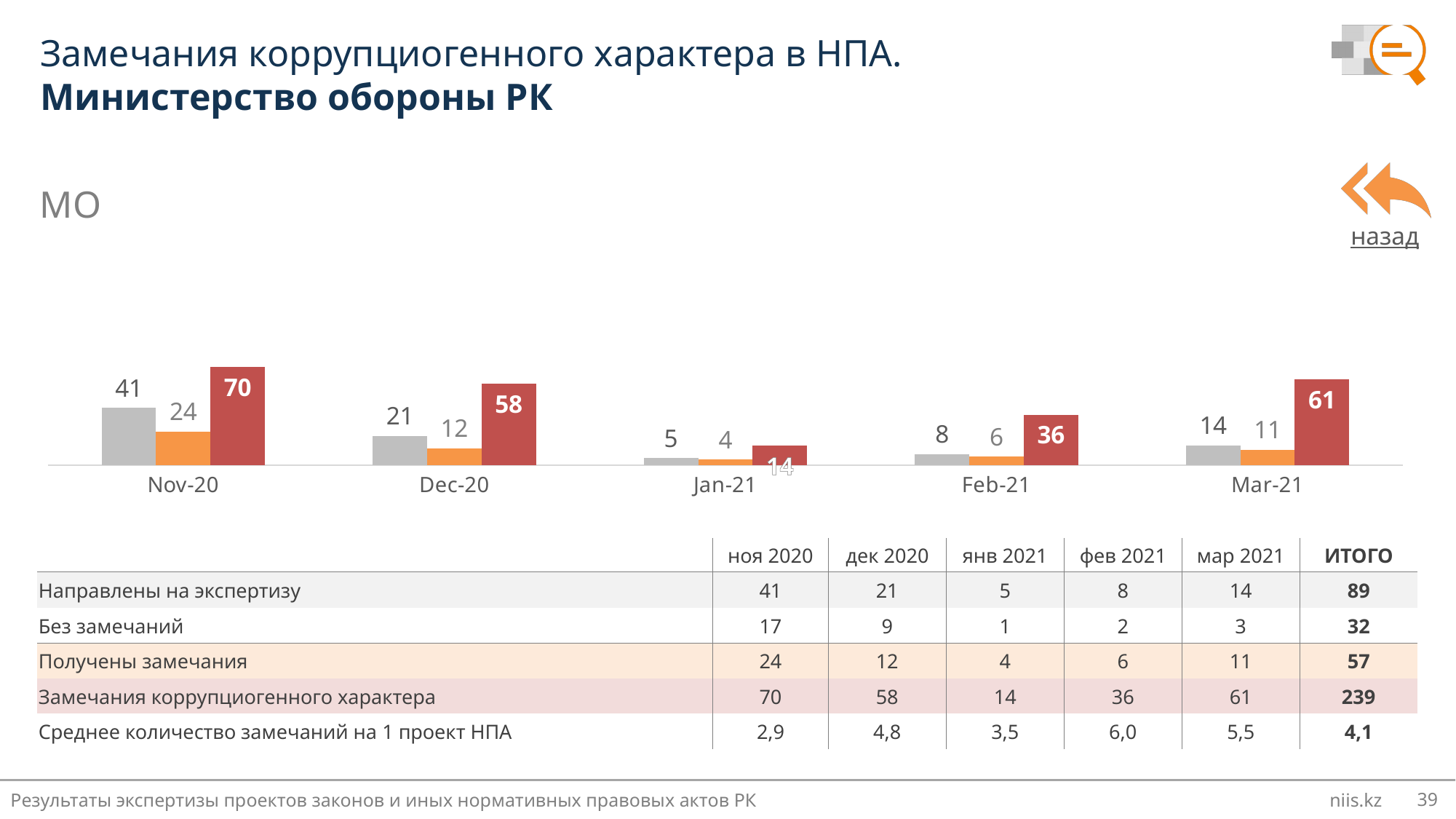
What is the value of the red bar (Замечания коррупциогенного характера) for Nov-20? 70 What is the value of the orange bar (Получены замечания) for Mar-21? 11 Which is larger: the red bar for Feb-21 or the red bar for Mar-21? Mar-21 What kind of chart is shown on the slide? bar chart Do the grey bar values (Направлены на экспертизу) rise or fall from Nov-20 to Jan-21? fall What is the value of the red bar (Замечания коррупциогенного характера) for Jan-21? 14 How many data series (bars per month) are plotted in the chart? 3 In which month is the red bar (Замечания коррупциогенного характера) the highest? Nov-20 How many months (categories) are shown on the x axis of the chart? 5 What is the value of the grey bar (Направлены на экспертизу) for Dec-20? 21 What is the difference between the red bar values for Nov-20 and Dec-20? 12 In which month is the grey bar (Направлены на экспертизу) the lowest? Jan-21